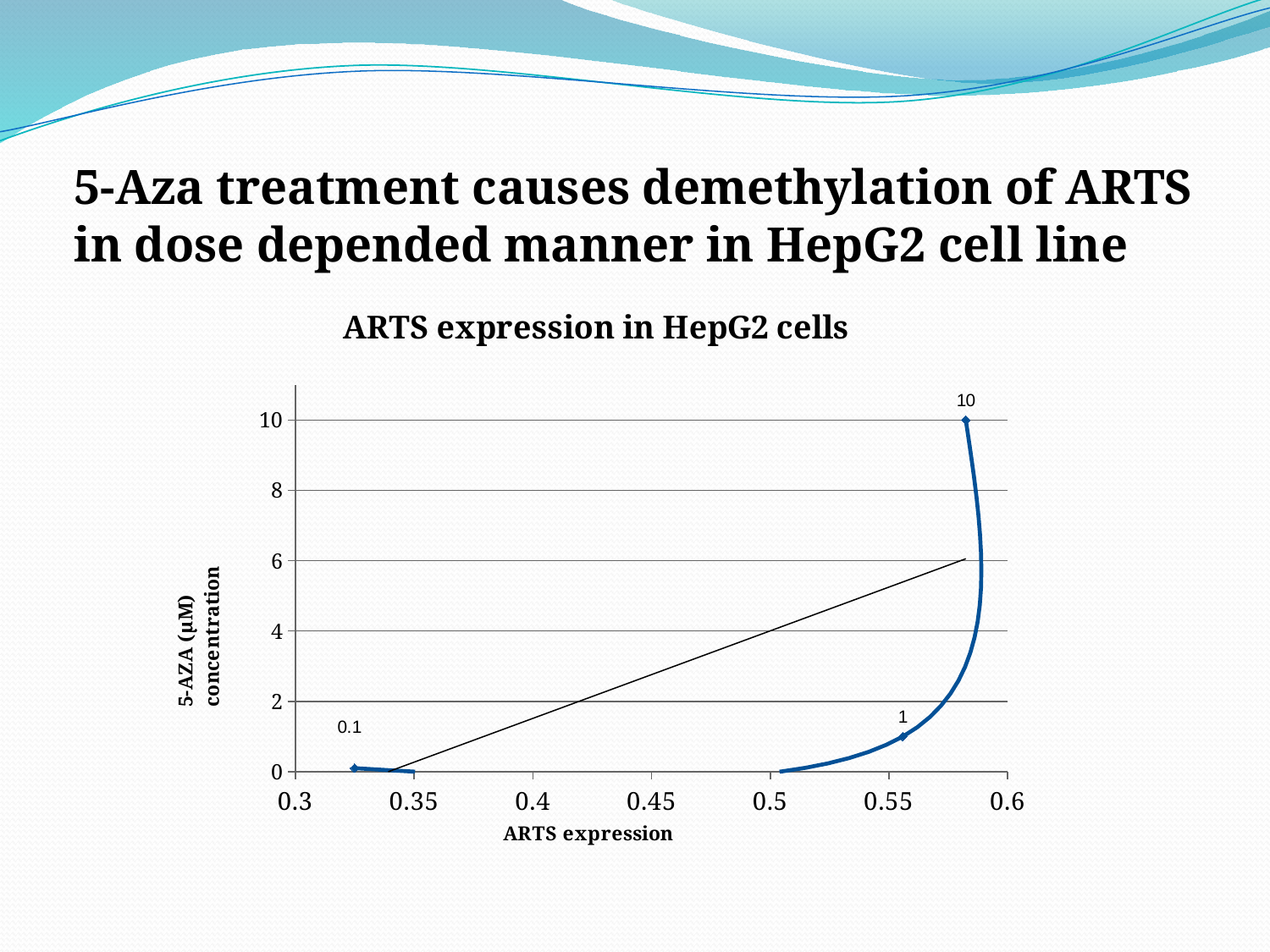
How many data points are labelled on the chart? 3 Is the ARTS expression for the point labelled 10 greater or less than 0.55? greater Does ARTS expression rise or fall as the 5-AZA concentration increases? rise What is the title of the chart? ARTS expression in HepG2 cells Is the ARTS expression for the point labelled 1 greater or less than 0.5? greater Which labelled point has the highest ARTS expression? 10 Which labelled point has the lowest ARTS expression? 0.1 Is the ARTS expression for the point labelled 0.1 greater or less than 0.35? less What is the lowest 5-AZA concentration plotted on the chart? 0.1 What is the label of the x axis? ARTS expression What is the highest 5-AZA concentration plotted on the chart? 10 What kind of chart is shown on the slide? scatter chart with smoothed lines